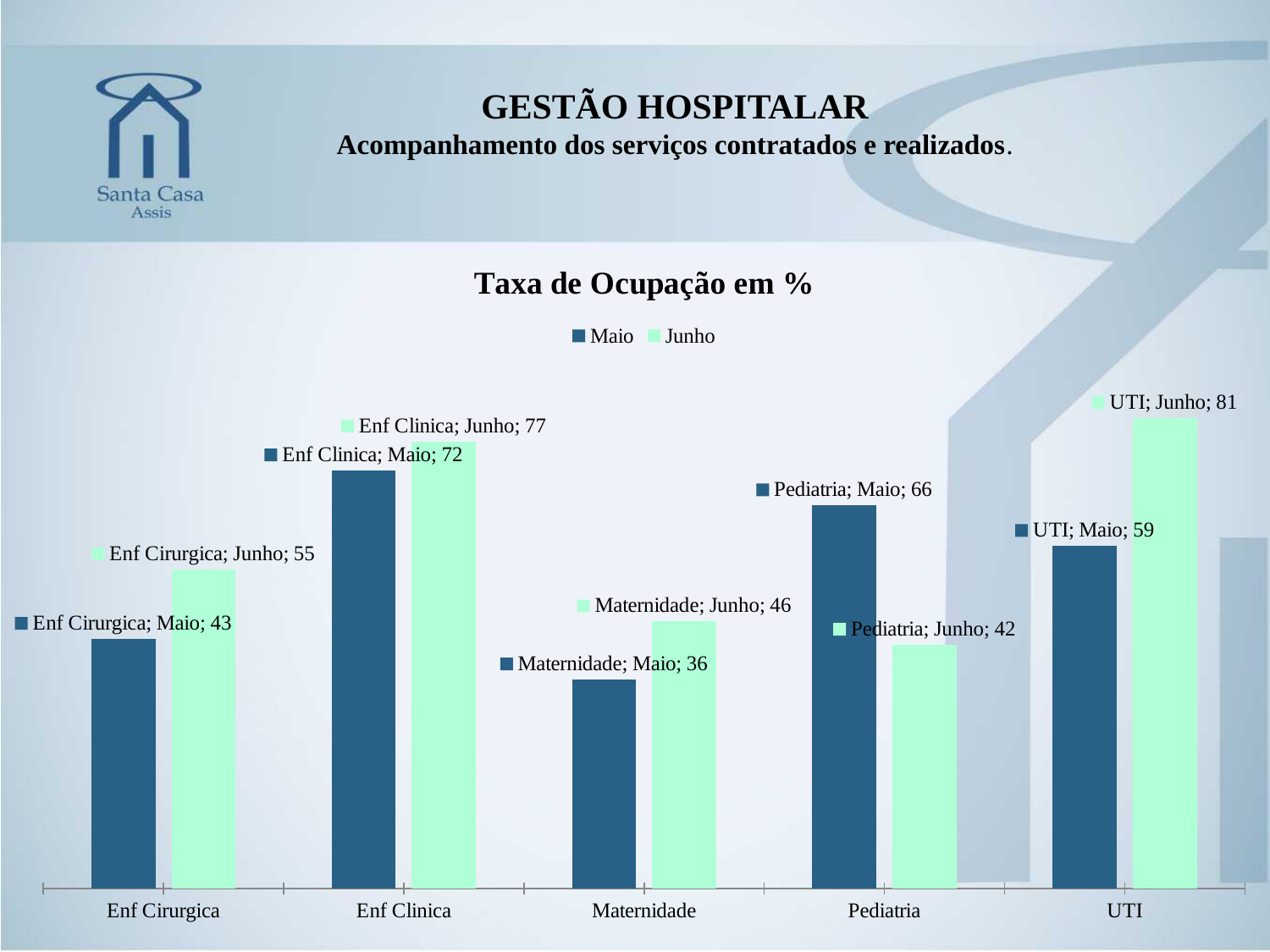
Which category has the lowest Maio value? Maternidade Which is larger for Pediatria, the Maio value or the Junho value? Maio What is the difference between the Junho and Maio values for Enf Cirurgica? 12 What kind of chart is shown on the slide? Bar chart How many series does the legend list? 2 What is the title of the chart? Taxa de Ocupação em % What is the difference between the Junho and Maio values for UTI? 22 What is the Maio value for Maternidade? 36 Which category has the highest Junho value? UTI What is the Maio value for Enf Cirurgica? 43 What is the Junho value for UTI? 81 How many categories are shown on the x axis? 5